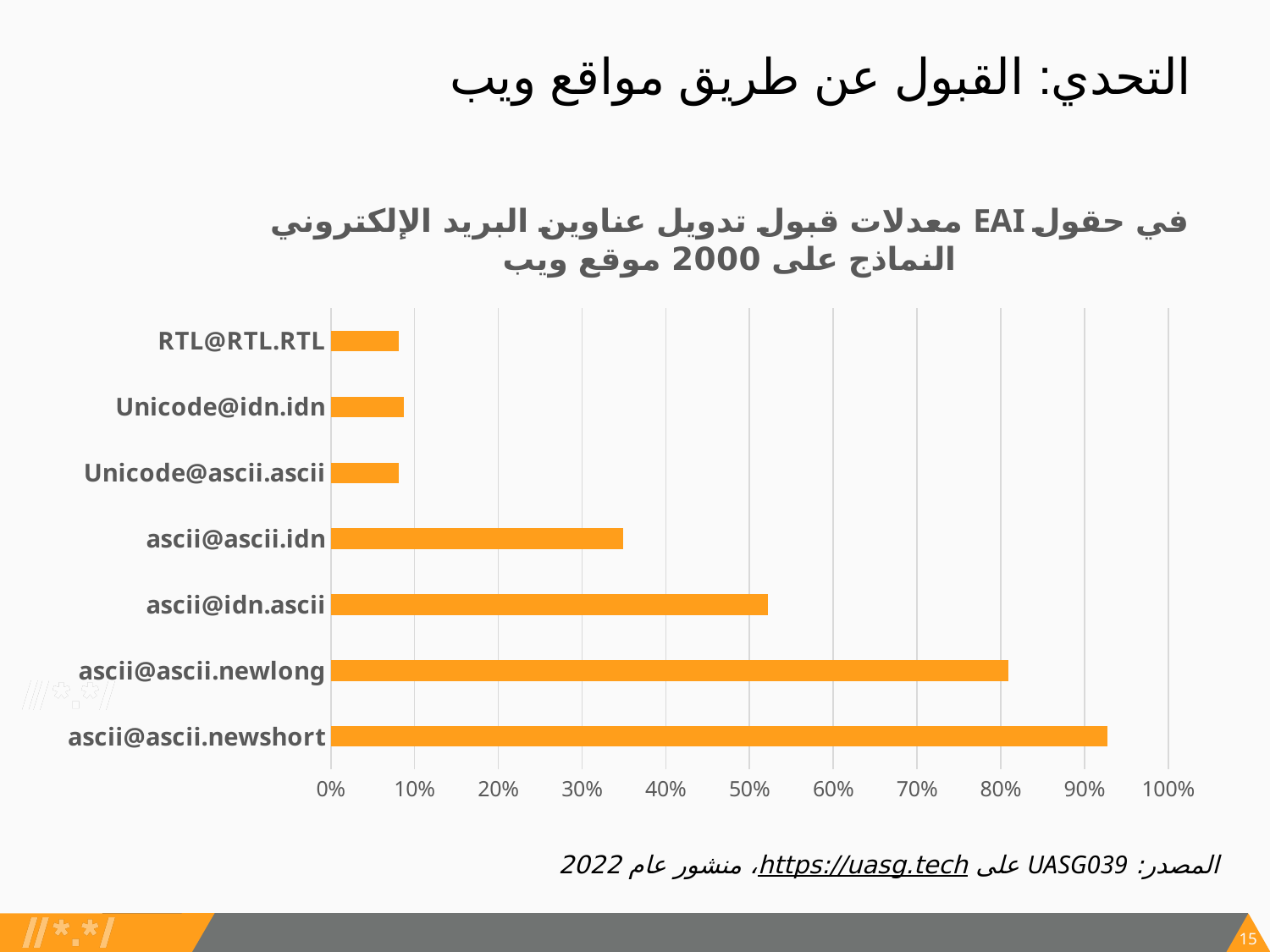
What kind of chart is shown on the slide? bar chart What is the maximum value shown on the horizontal axis of the chart? 100% Is the value for ascii@ascii.idn greater or less than 40%? less Is the value for Unicode@idn.idn greater or less than 10%? less Which is larger, the value for ascii@idn.ascii or the value for ascii@ascii.idn? ascii@idn.ascii Which is larger, the value for ascii@ascii.newlong or the value for Unicode@ascii.ascii? ascii@ascii.newlong How many categories are plotted in the chart? 7 Is the value for ascii@idn.ascii greater or less than 50%? greater Which category has the highest acceptance rate? ascii@ascii.newshort